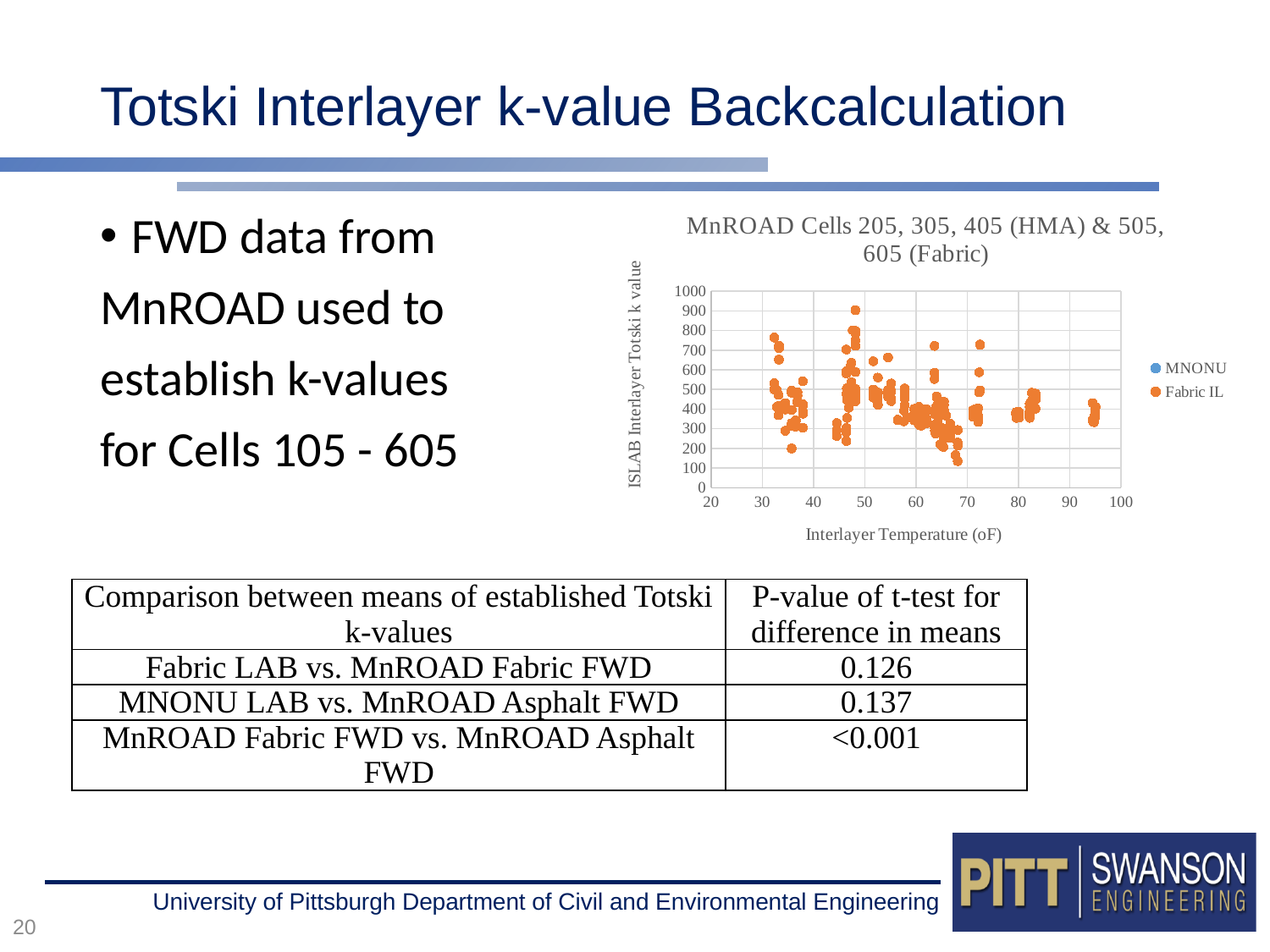
What are the two series named in the chart legend? MNONU and Fabric IL What kind of chart is shown on the slide? scatter chart How many series does the chart legend list? 2 What is the label of the chart's x axis? Interlayer Temperature (oF) What is the highest value shown on the chart's x axis? 100 What is the label of the chart's y axis? ISLAB Interlayer Totski k value Is the lowest plotted k value on the chart greater or less than 200? less What is the highest value shown on the chart's y axis? 1000 Are the plotted points at an interlayer temperature of about 95 greater or less than 600? less What is the title of the chart? MnROAD Cells 205, 305, 405 (HMA) & 505, 605 (Fabric) Is the highest plotted k value on the chart greater or less than 800? greater